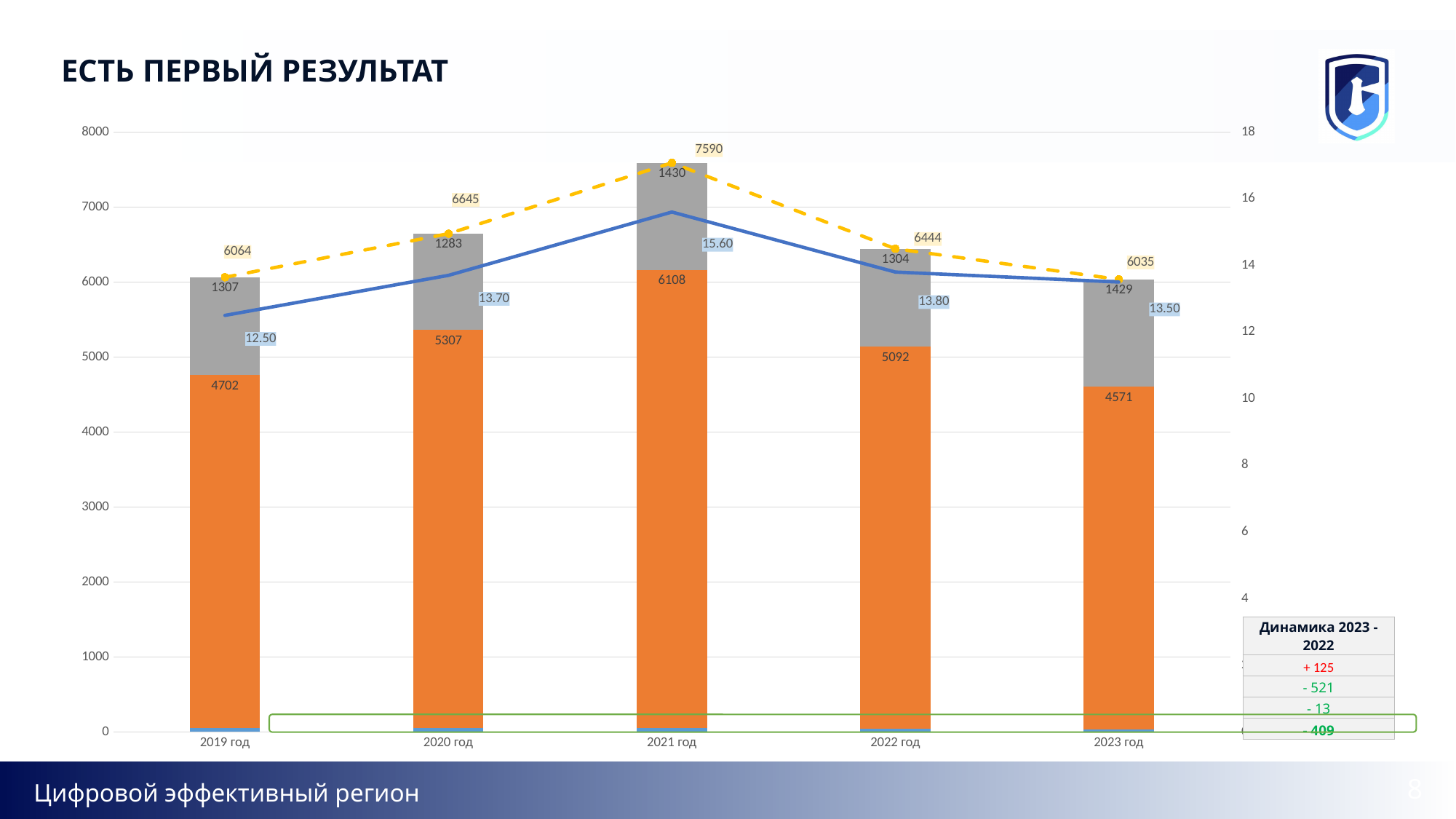
What is the difference between the orange segment values for 2021 год and 2019 год? 1406 How does the solid blue line change from 2021 год to 2023 год? It falls Is the value of the dashed yellow line for 2021 год greater or less than 7000? greater What value does the solid blue line show for 2022 год? 13.80 What is the title of the slide containing the chart? ЕСТЬ ПЕРВЫЙ РЕЗУЛЬТАТ What is the value of the grey bar segment for 2023 год? 1429 What is the value of the orange bar segment for 2021 год? 6108 Which is larger: the grey segment for 2021 год or the grey segment for 2020 год? 2021 год In which year is the orange bar segment the smallest? 2023 год What value does the dashed yellow line show for 2020 год? 6645 In which year does the dashed yellow line reach its highest value? 2021 год How many years are shown on the x axis? 5